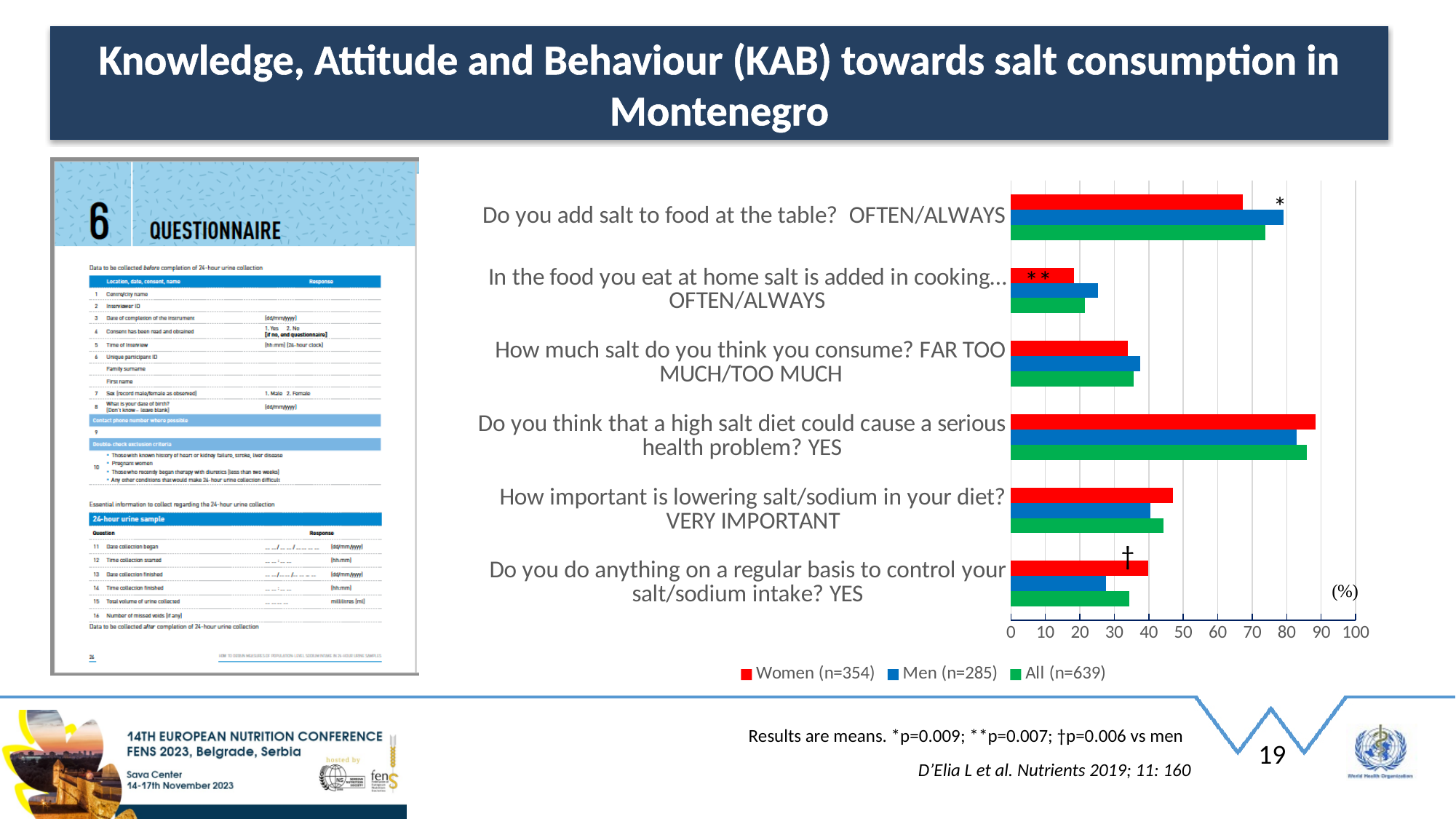
Is the Men value for "In the food you eat at home salt is added in cooking... OFTEN/ALWAYS" greater or less than 30? less Is the Women value for "Do you think that a high salt diet could cause a serious health problem? YES" greater or less than 80? greater Is the All value for "Do you add salt to food at the table? OFTEN/ALWAYS" greater or less than 70? greater For "Do you add salt to food at the table? OFTEN/ALWAYS", which is larger: the Women value or the Men value? Men What kind of chart is shown on the slide? Bar chart For "Do you do anything on a regular basis to control your salt/sodium intake? YES", which is larger: the Women value or the Men value? Women What sample size is given for the Women series in the legend? n=354 Which survey question has the lowest Women value? In the food you eat at home salt is added in cooking... OFTEN/ALWAYS What unit is shown on the chart's horizontal axis? (%) How many survey questions (categories) are plotted on the chart? 6 Which survey question has the highest Women value? Do you think that a high salt diet could cause a serious health problem? YES How many series does the chart legend list? 3